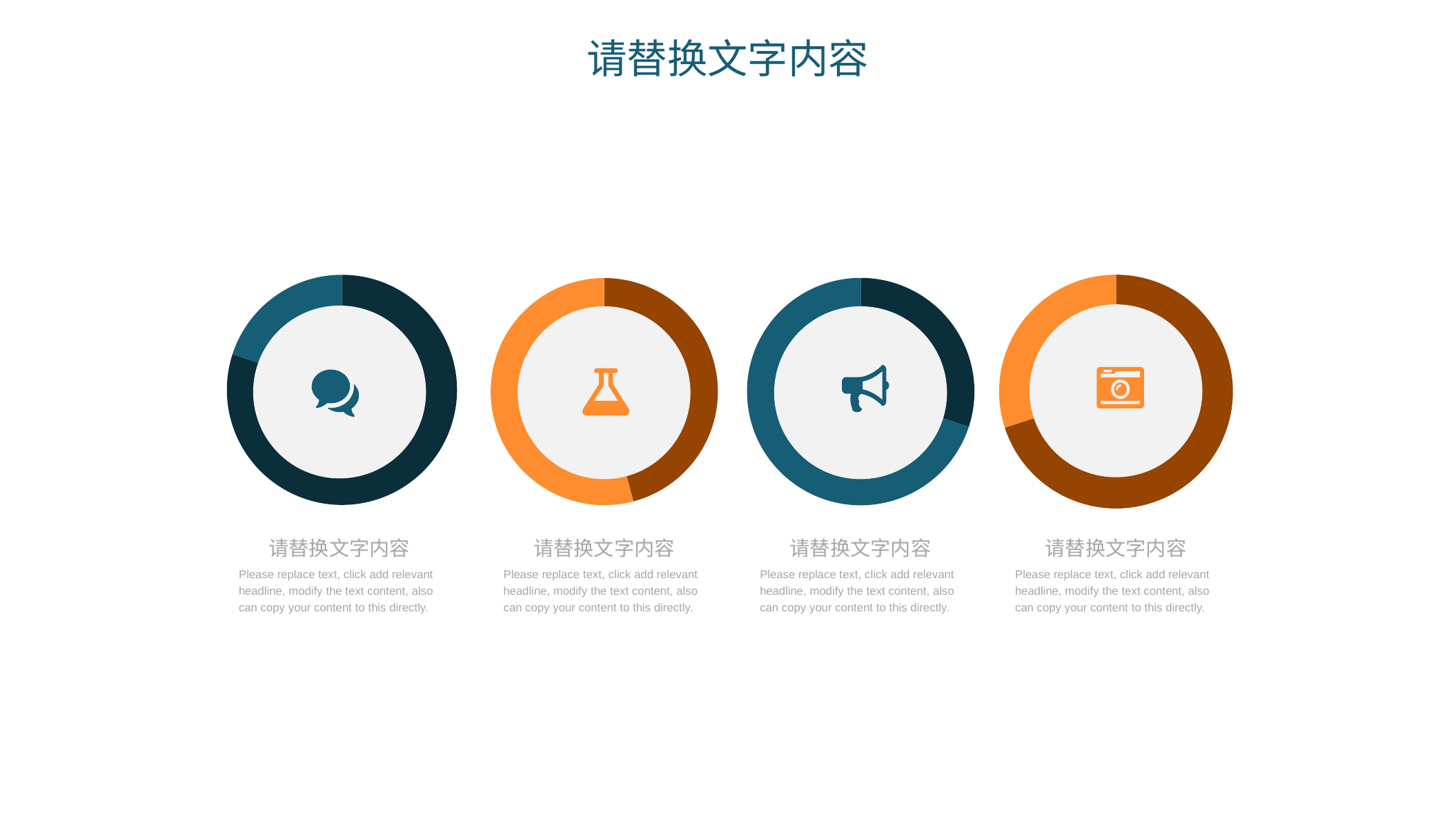
How many doughnut charts are shown on the slide? 4 How many segments does the second doughnut chart from the left have? 2 In the rightmost doughnut chart, which segment is larger, the orange one or the brown one? the brown one In the third doughnut chart from the left, which segment is larger, the dark navy one or the lighter teal one? the lighter teal one In the leftmost doughnut chart, which segment is larger, the dark navy one or the lighter teal one? the dark navy one What kind of chart is the rightmost chart on the slide? doughnut chart What kind of chart is the leftmost chart on the slide? doughnut chart How many segments does the rightmost doughnut chart have? 2 Which two colours are used for the segments of the second doughnut chart from the left? orange and brown Does the leftmost doughnut chart show any data labels or a legend? No